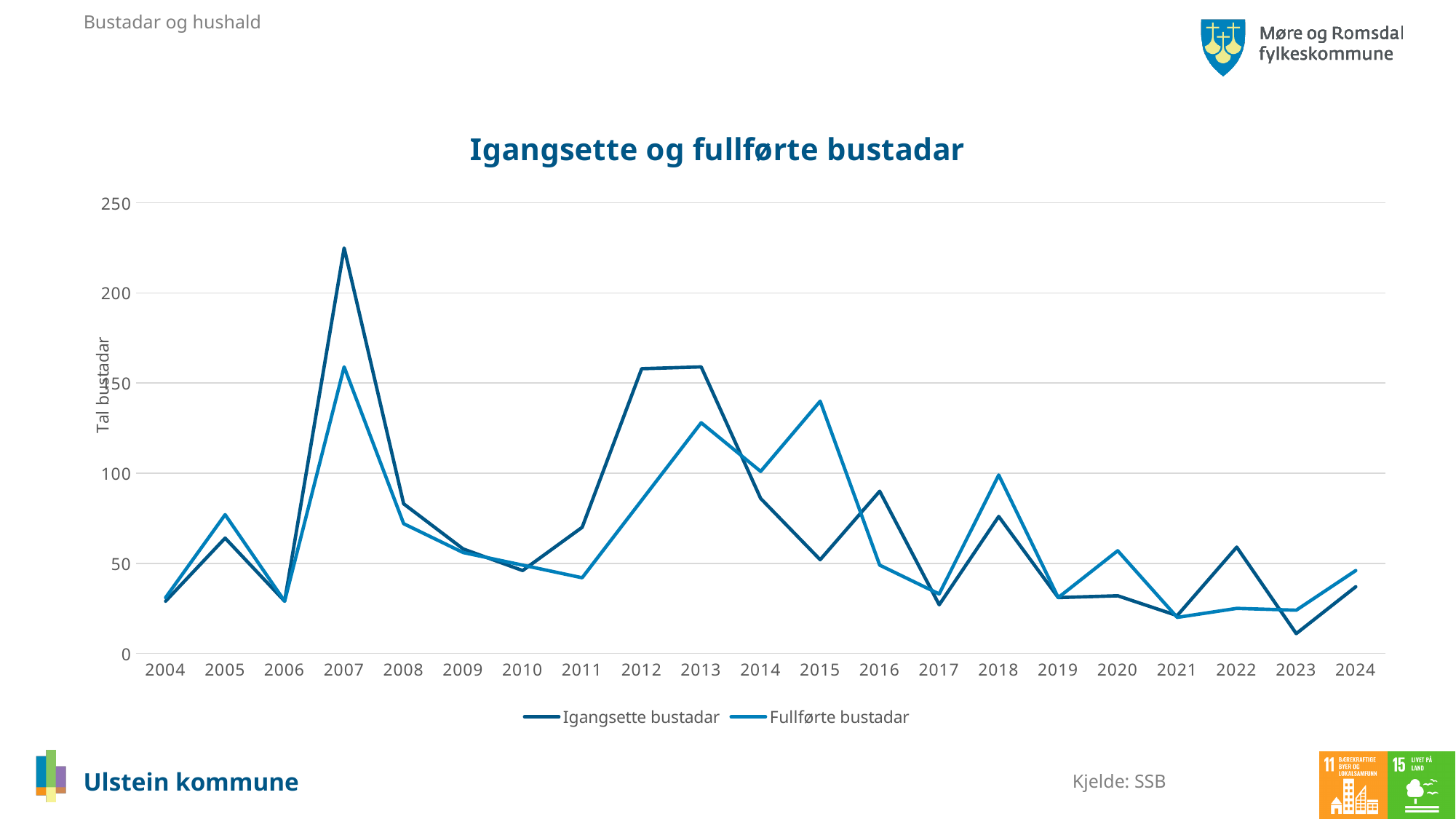
How many years are plotted along the x axis? 21 Is the value for Igangsette bustadar in 2023 greater or less than 50? less Does the Igangsette bustadar series rise or fall from 2007 to 2010? Fall What kind of chart is shown on the slide? Line chart In which year does the Igangsette bustadar series reach its lowest value? 2023 Is the value for Fullførte bustadar in 2015 greater or less than 100? greater Is the value for Igangsette bustadar in 2007 greater or less than 200? greater In 2016, which series has the larger value, Igangsette bustadar or Fullførte bustadar? Igangsette bustadar In which year does the Fullførte bustadar series reach its highest value? 2007 In which year does the Igangsette bustadar series reach its highest value? 2007 How many series does the legend list? 2 What is the title of the chart? Igangsette og fullførte bustadar